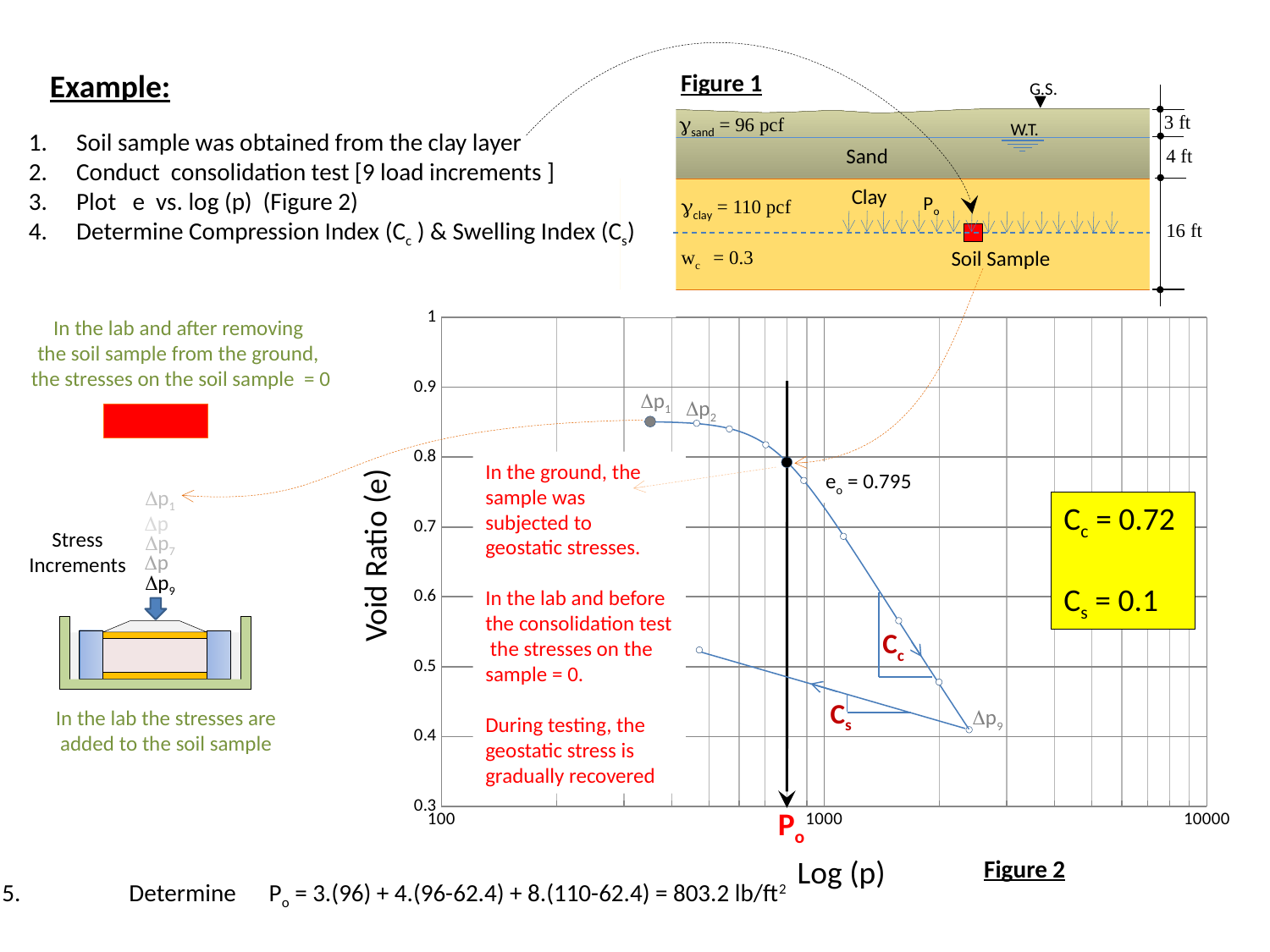
In Figure 2, is the void ratio at Δp9 greater or less than 0.5? less What kind of chart is Figure 2? line chart In Figure 2, is the void ratio at Δp1 greater or less than 0.8? greater In Figure 2, which labeled point has the higher void ratio, Δp1 or Δp9? Δp1 How many load increments were applied in the consolidation test plotted in Figure 2? 9 What is the value of P_o computed on the slide? 803.2 lb/ft² In Figure 2, what is the value of the Swelling Index C_s shown on the slide? 0.1 In Figure 2, what is the void ratio e_o at the in-situ stress P_o? 0.795 What is the label of the vertical axis in Figure 2? Void Ratio (e) What is the label of the horizontal axis in Figure 2? Log (p) In Figure 2, does the void ratio rise or fall as log(p) increases along the loading curve? fall In Figure 2, what is the value of the Compression Index C_c shown on the slide? 0.72